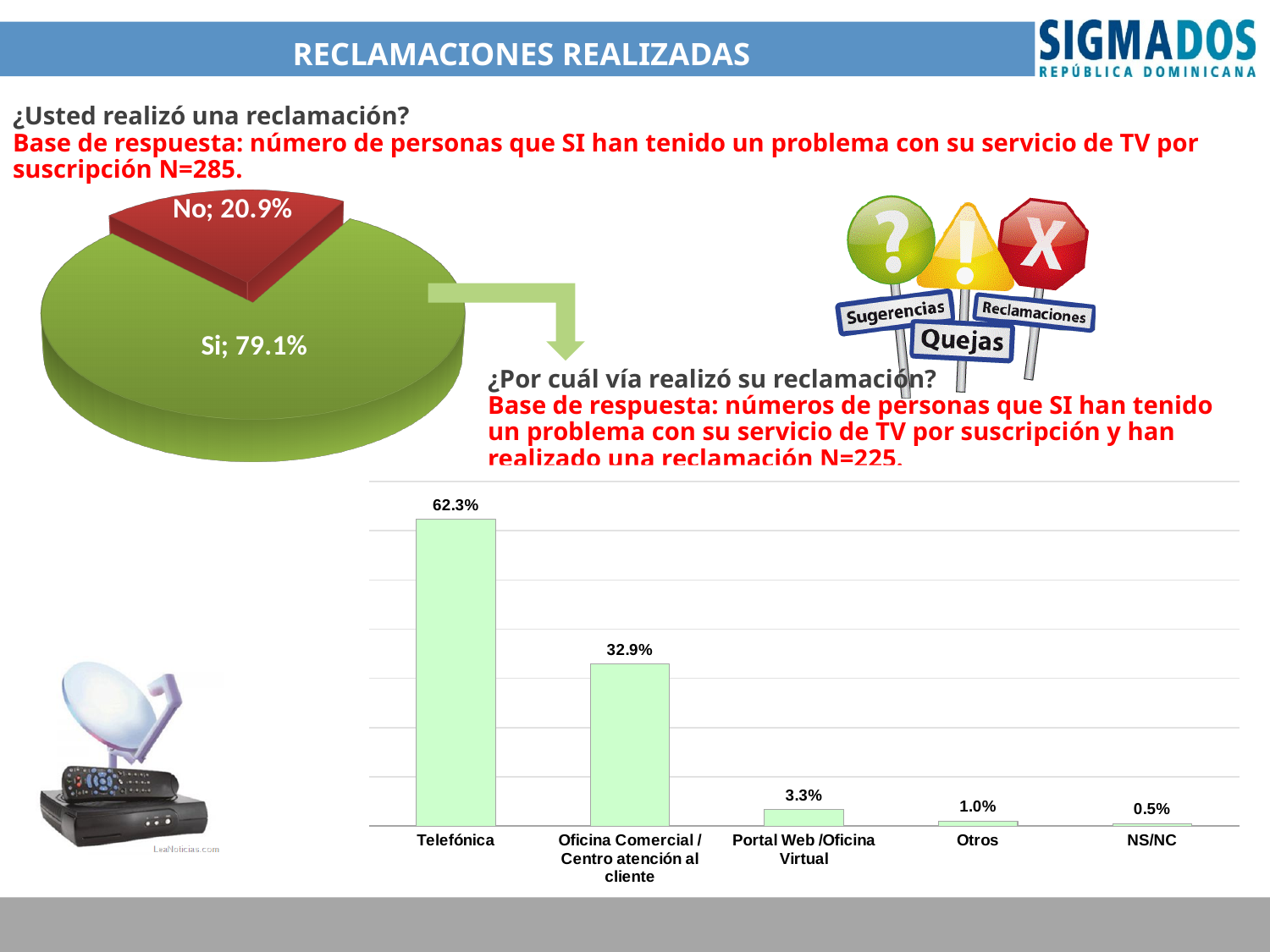
In the pie chart on the left, which slice is larger, 'Si' or 'No'? Si In the pie chart on the left, what percentage of respondents answered 'Si'? 79.1% How many categories are shown in the bar chart at the bottom? 5 In the bar chart at the bottom, what is the value for 'Portal Web /Oficina Virtual'? 3.3% In the pie chart on the left, what is the difference between the 'Si' and 'No' percentages? 58.2% In the bar chart at the bottom, which category has the highest value? Telefónica In the bar chart at the bottom, which category has the lowest value? NS/NC In the bar chart at the bottom, what is the difference between 'Telefónica' and 'Oficina Comercial / Centro atención al cliente'? 29.4% In the bar chart at the bottom, what is the value for 'Oficina Comercial / Centro atención al cliente'? 32.9% What kind of chart is the one on the left showing 'Si' and 'No'? Pie chart In the pie chart on the left, what percentage of respondents answered 'No'? 20.9% In the bar chart at the bottom, what is the value for 'Telefónica'? 62.3%